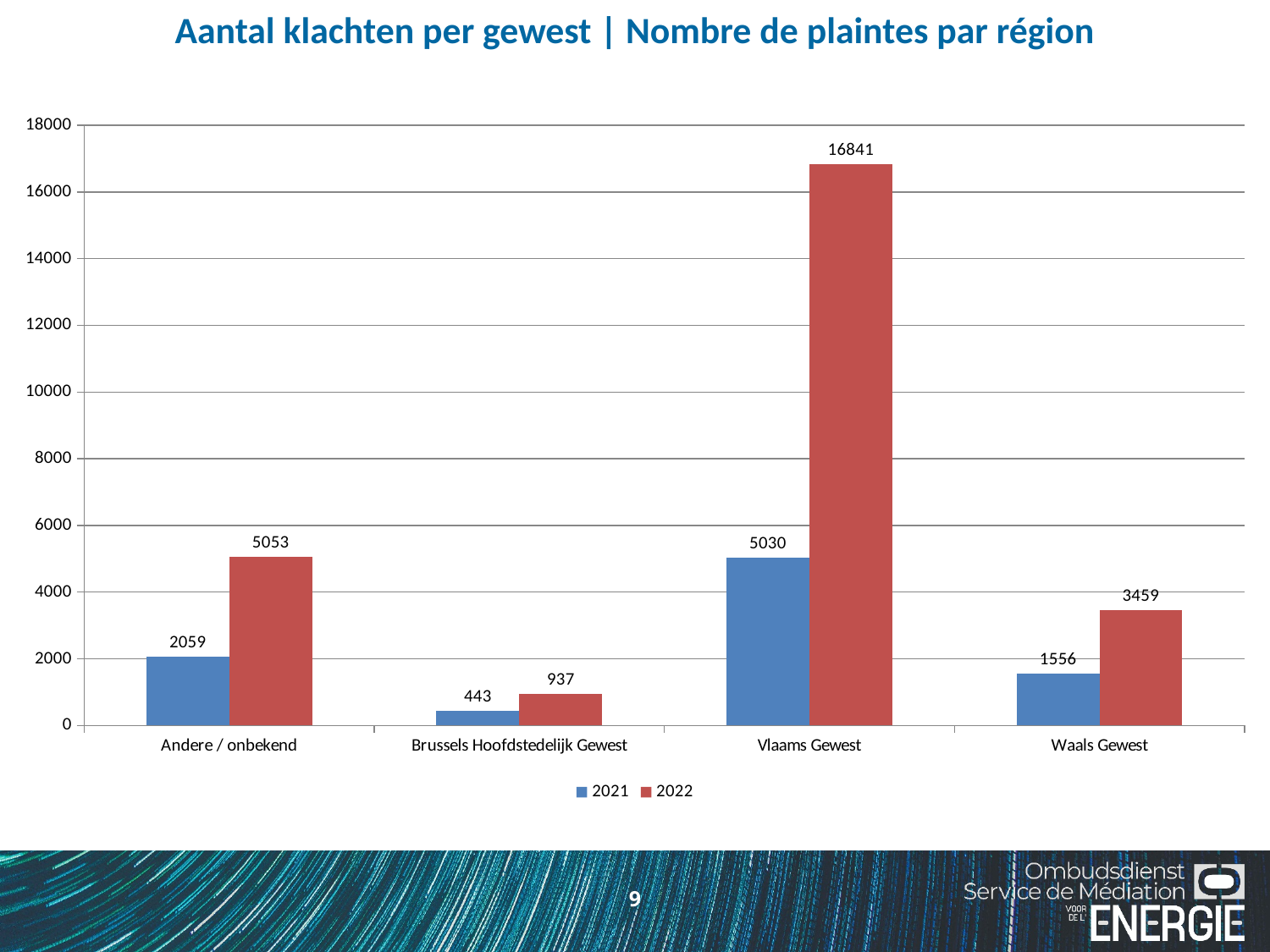
What is the value for Brussels Hoofdstedelijk Gewest in 2021? 443 Which region has the highest value in 2022? Vlaams Gewest What is the value for Waals Gewest in 2022? 3459 Which colour represents the 2022 series in the legend? Red What kind of chart is shown on the slide? Bar chart Which is larger: the 2021 value for Andere / onbekend or the 2021 value for Waals Gewest? Andere / onbekend How many series does the legend list? 2 What is the difference between the 2022 and 2021 values for Vlaams Gewest? 11811 How many regions (categories) are shown on the x axis? 4 What is the difference between the 2022 and 2021 values for Andere / onbekend? 2994 What is the value for Vlaams Gewest in 2022? 16841 Which region has the lowest value in 2021? Brussels Hoofdstedelijk Gewest